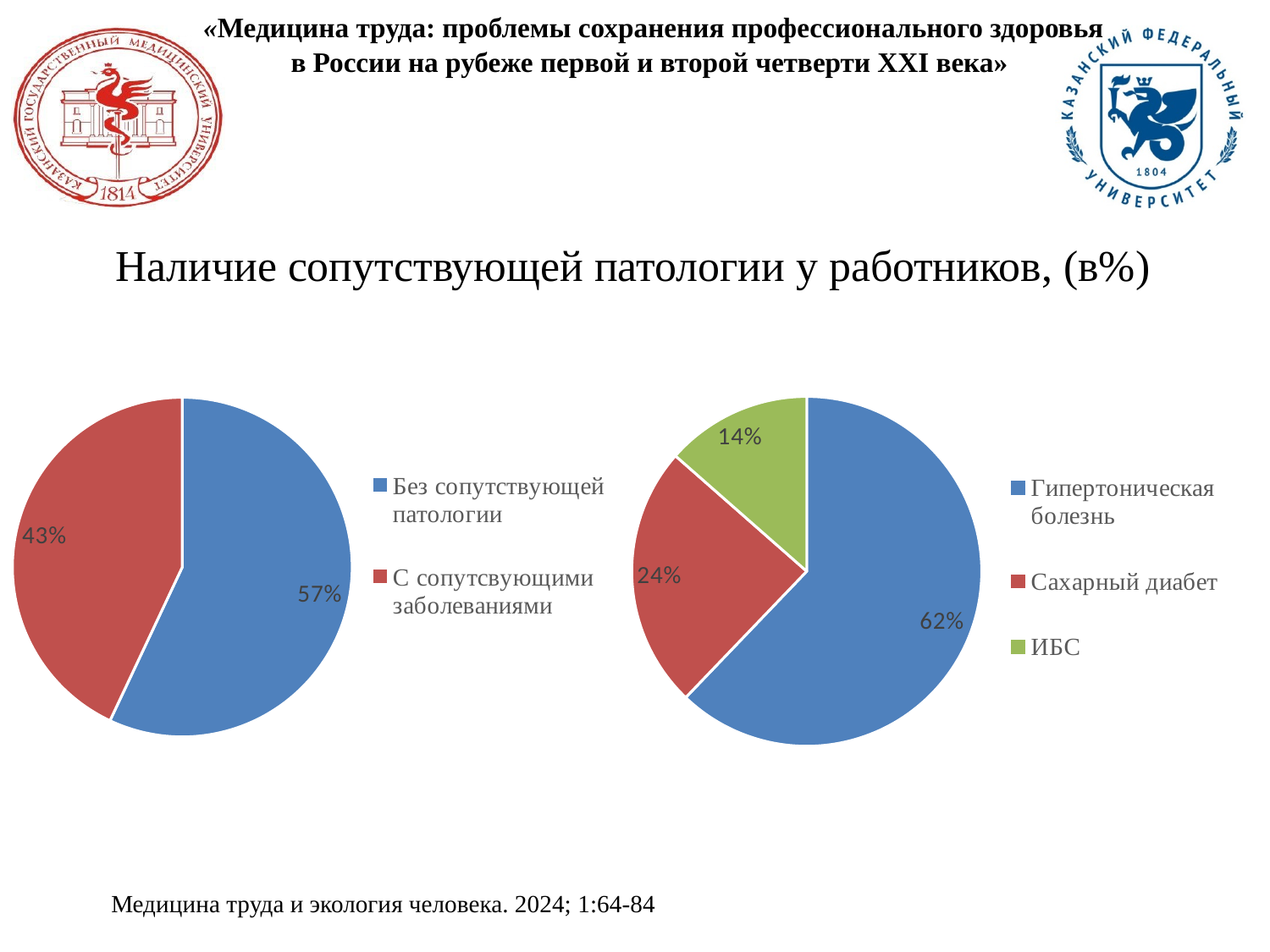
In the right pie chart, what is the share for 'Сахарный диабет'? 24% In the right pie chart, what is the difference between the shares for 'Сахарный диабет' and 'ИБС'? 10% What type of chart is the left chart on the slide? Pie chart In the left pie chart, what is the share for 'С сопутсвующими заболеваниями'? 43% How many categories does the legend of the right pie chart list? 3 In the right pie chart, what is the share for 'ИБС'? 14% In the right pie chart, what is the share for 'Гипертоническая болезнь'? 62% In the right pie chart, which category has the largest share? Гипертоническая болезнь In the right pie chart, which category has the smallest share? ИБС In the left pie chart, what is the share for 'Без сопутствующей патологии'? 57% In the left pie chart, what is the difference between the shares for 'Без сопутствующей патологии' and 'С сопутсвующими заболеваниями'? 14% In the right pie chart, which is larger: the share for 'Сахарный диабет' or the share for 'ИБС'? Сахарный диабет